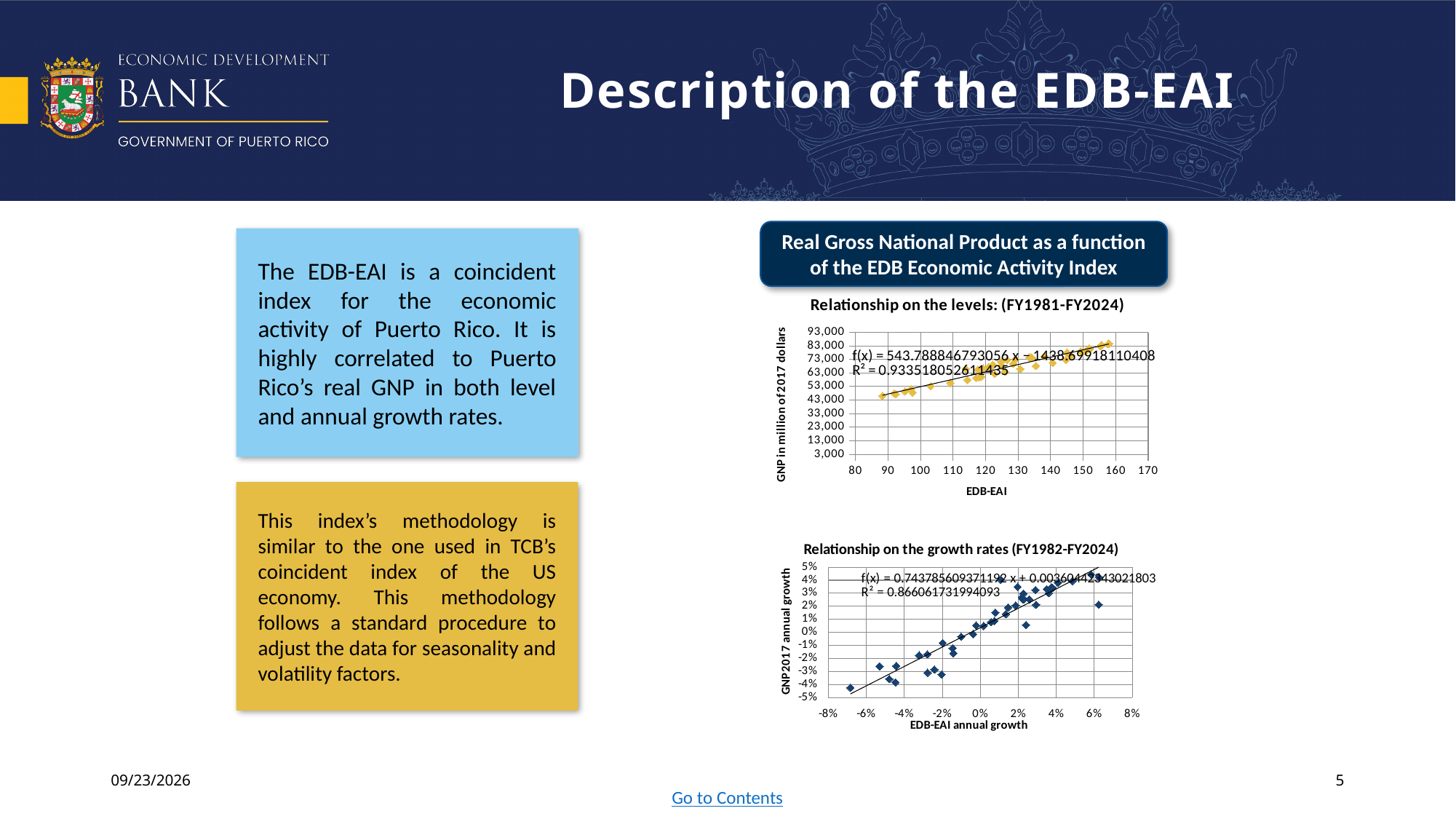
What is the R² value shown on the top chart 'Relationship on the levels'? 0.933518052611435 In the top chart 'Relationship on the levels', is the GNP value for the points with the highest EDB-EAI (around 157) greater or less than 73,000? greater In the top chart 'Relationship on the levels', do GNP values rise or fall as the EDB-EAI increases along the x axis? rise What kind of chart is the top chart titled 'Relationship on the levels: (FY1981-FY2024)'? scatter chart What is the fitted line equation shown on the bottom chart 'Relationship on the growth rates'? f(x) = 0.743785609371192 x + 0.00360442343021803 What is the fitted line equation shown on the top chart 'Relationship on the levels'? f(x) = 543.788846793056 x − 1438.69918110408 In the bottom chart 'Relationship on the growth rates', does GNP annual growth rise or fall as EDB-EAI annual growth increases along the x axis? rise What kind of chart is the bottom chart titled 'Relationship on the growth rates (FY1982-FY2024)'? scatter chart What is the x-axis title of the bottom chart 'Relationship on the growth rates'? EDB-EAI annual growth What is the R² value shown on the bottom chart 'Relationship on the growth rates'? 0.866061731994093 What is the y-axis title of the top chart 'Relationship on the levels'? GNP in million of 2017 dollars